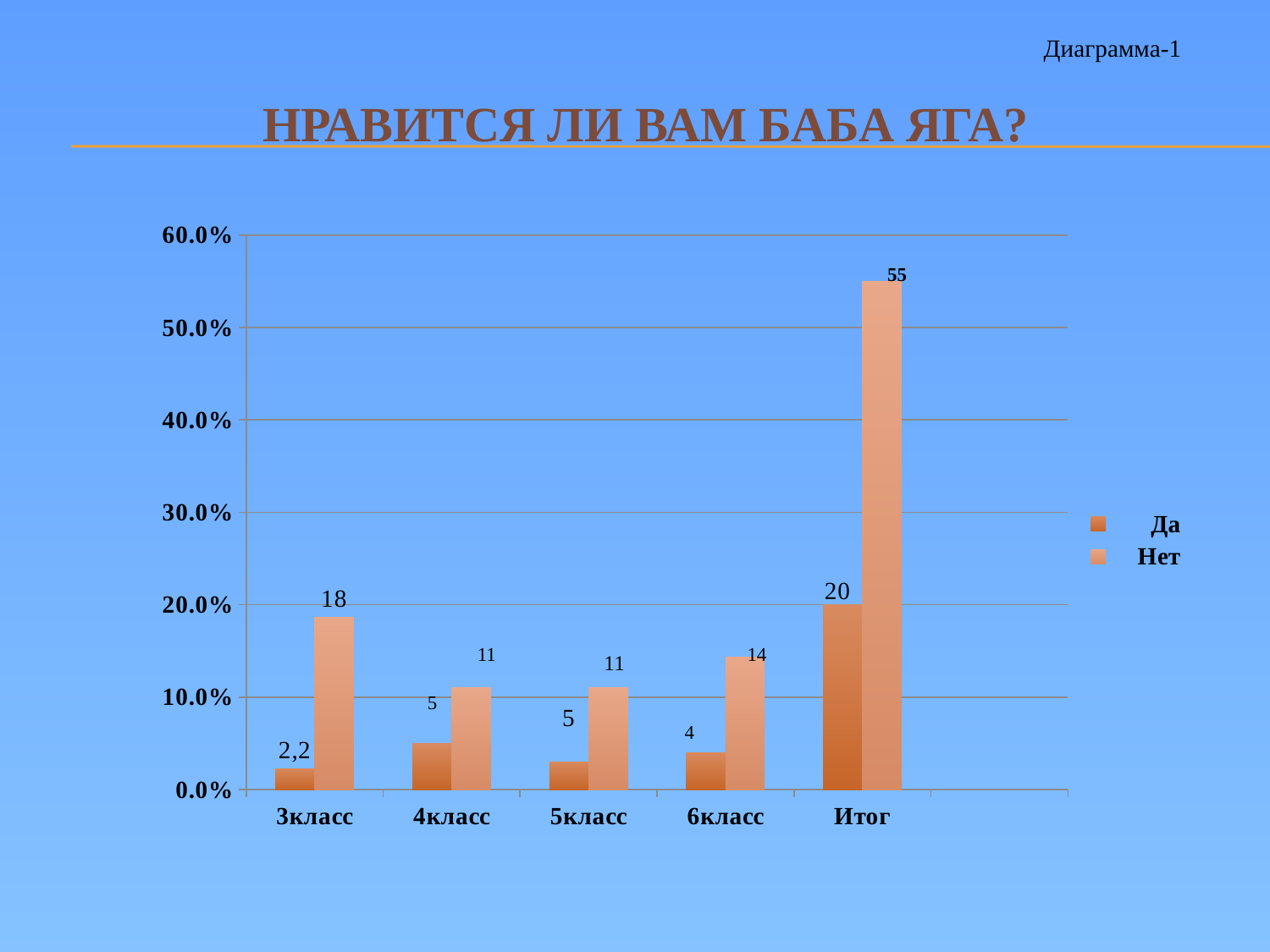
For 6класс, what is the difference between the Нет value and the Да value? 10 For Итог, what is the difference between the Нет value and the Да value? 35 What is the value of the Нет series for 6класс? 14 What kind of chart is shown on the slide? bar chart Which is larger: the Нет value for 3класс or the Нет value for 4класс? 3класс How many categories are shown on the x axis? 5 How many series does the legend list? 2 What is the value of the Нет series for Итог? 55 What is the value of the Да series for 3класс? 2,2 What is the value of the Да series for Итог? 20 Which category has the lowest value in the Да series? 3класс Which category has the highest value in the Нет series? Итог